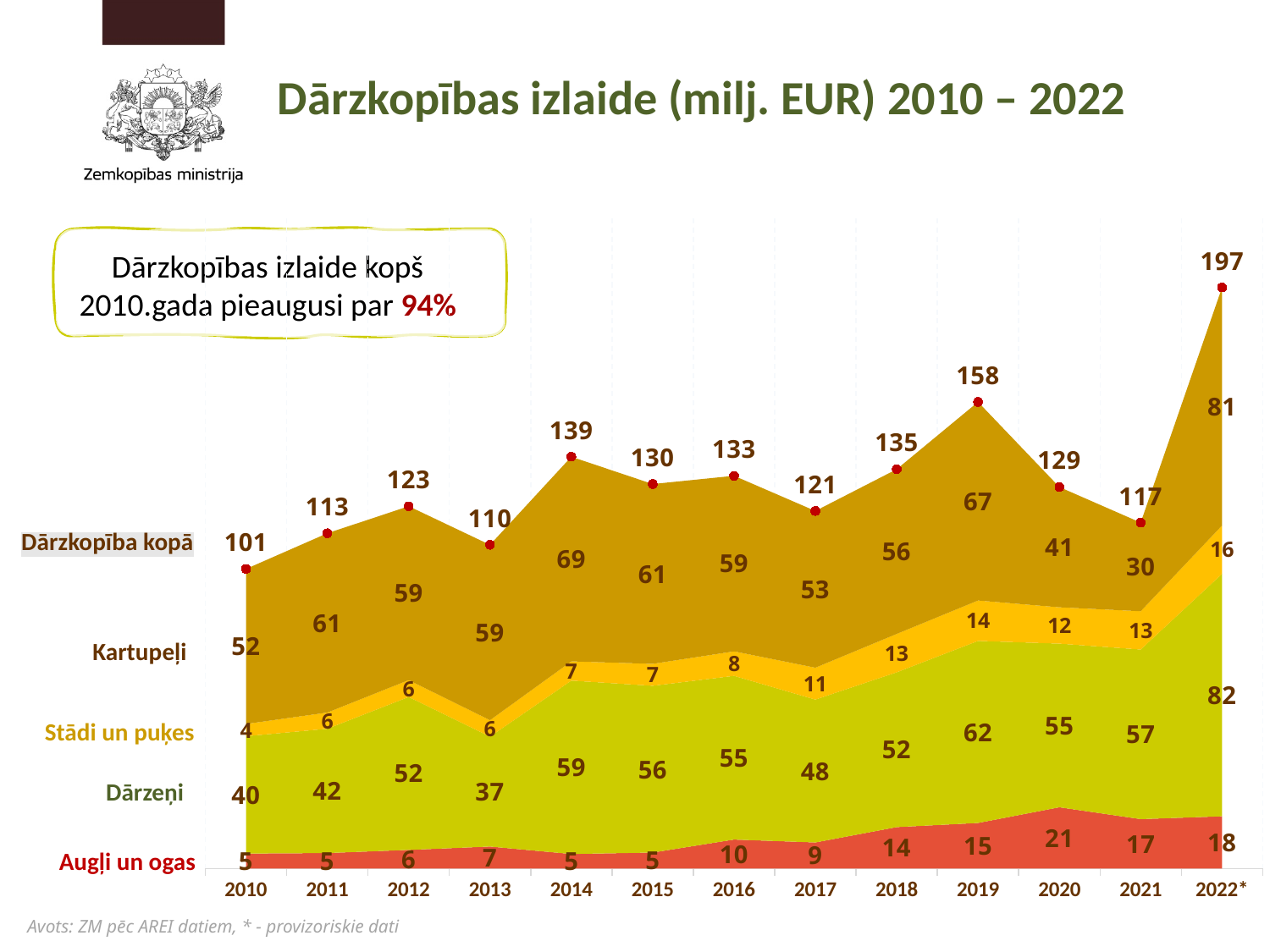
By what percentage does the text box say horticulture output has grown since 2010? 94% How many years are shown on the x axis? 13 What is the value for Augļi un ogas in 2020? 21 What is the value for Kartupeļi in 2014? 69 In which year is the Dārzkopība kopā value highest? 2022* Does the Stādi un puķes value rise or fall from 2010 to 2022*? Rise Which is larger in 2013: Kartupeļi or Dārzeņi? Kartupeļi What was the total horticulture output (Dārzkopība kopā) in 2019? 158 What is the difference between the Dārzkopība kopā values for 2022* and 2021? 80 In which year is the Dārzkopība kopā value lowest? 2010 What kind of chart is this? Area chart What is the value for Dārzeņi in 2022*? 82